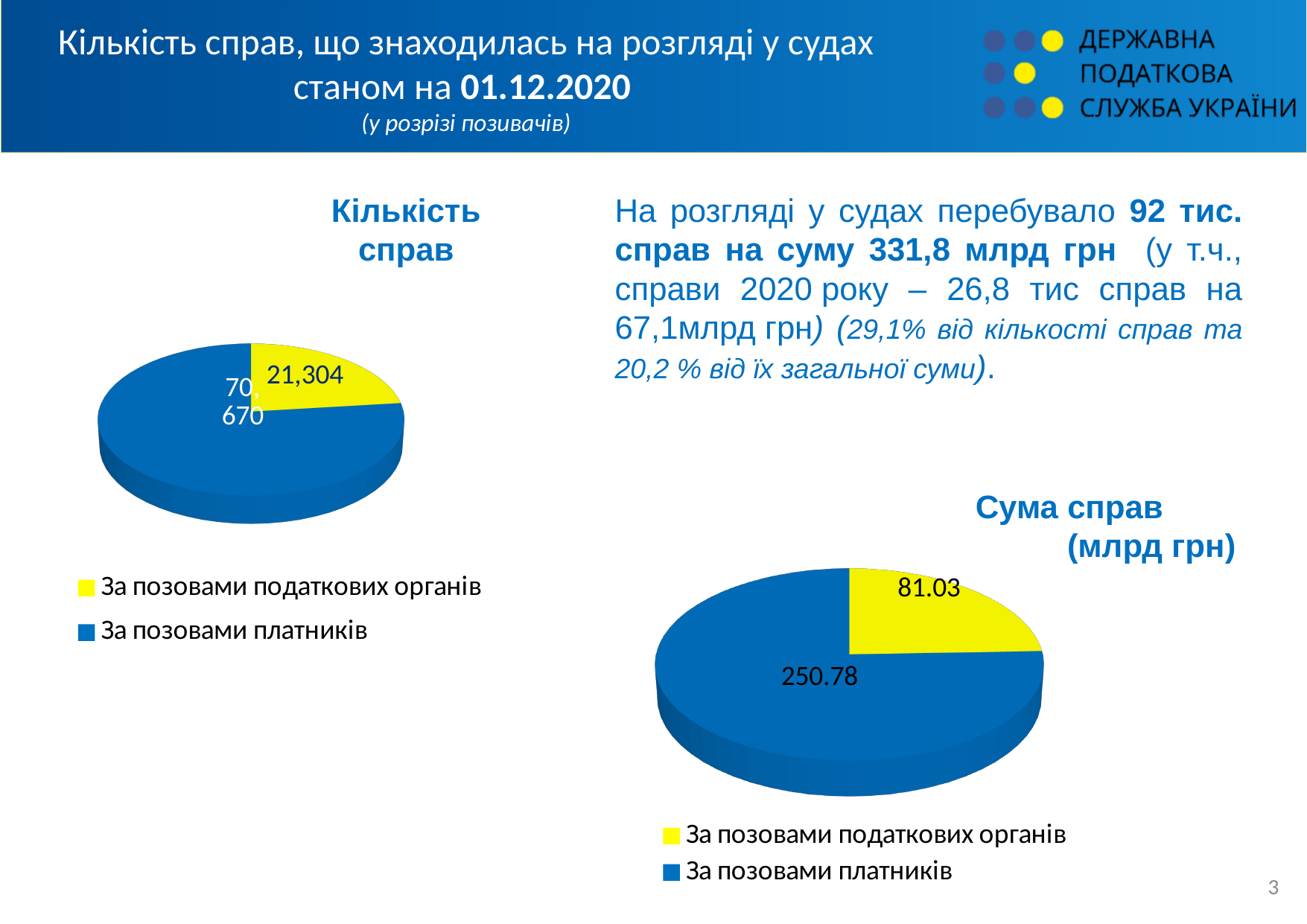
In the 'Кількість справ' pie chart, which category has the largest slice? За позовами платників In the 'Кількість справ' pie chart, what is the value for 'За позовами податкових органів'? 21,304 How many categories does the 'Сума справ (млрд грн)' pie chart show? 2 In the 'Сума справ (млрд грн)' pie chart, what is the value for 'За позовами податкових органів'? 81.03 In the 'Сума справ (млрд грн)' pie chart, what is the total of the two slices? 331.81 In the 'Кількість справ' pie chart, what is the value for 'За позовами платників'? 70,670 In the 'Кількість справ' pie chart, what is the difference between the values for 'За позовами платників' and 'За позовами податкових органів'? 49,366 In the 'Сума справ (млрд грн)' pie chart, which category has the smallest slice? За позовами податкових органів What type of chart is the 'Кількість справ' chart? Pie chart In the 'Кількість справ' pie chart, what colour is the slice for 'За позовами податкових органів'? Yellow In the 'Сума справ (млрд грн)' pie chart, what is the difference between the values for 'За позовами платників' and 'За позовами податкових органів'? 169.75 In the 'Сума справ (млрд грн)' pie chart, what is the value for 'За позовами платників'? 250.78